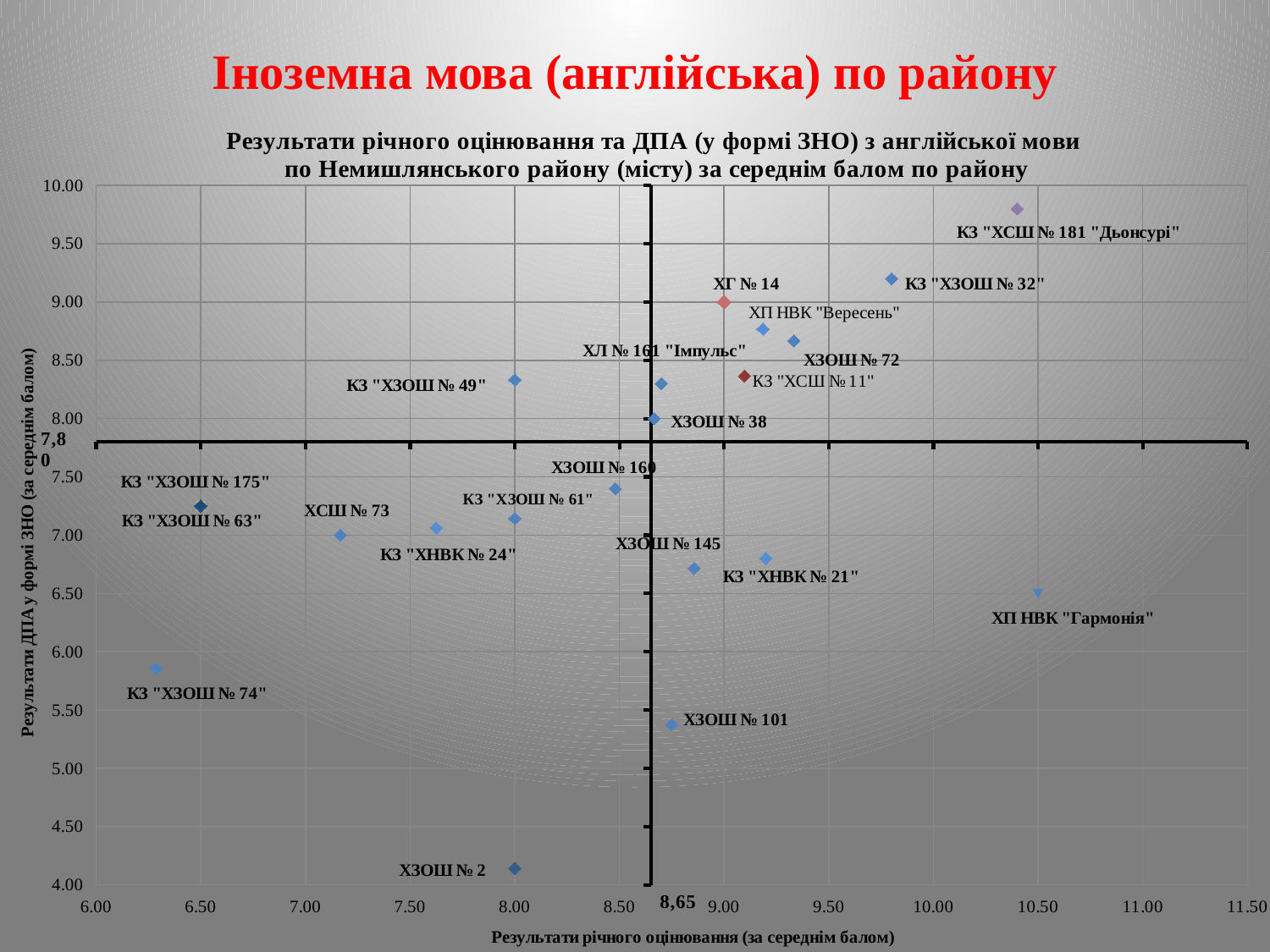
Is the ДПА result for ХЗОШ № 101 greater or less than 5.50? less Which has the higher ДПА result: ХЗОШ № 101 or ХЗОШ № 2? ХЗОШ № 101 What is the label of the x axis of the chart? Результати річного оцінювання (за середнім балом) Which has the higher annual assessment score: КЗ "ХЗОШ № 32" or ХГ № 14? КЗ "ХЗОШ № 32" Is the ДПА result for ХЗОШ № 2 greater or less than 4.50? less Which school has the lowest ДПА (ЗНО) result on the chart? ХЗОШ № 2 Is the ДПА result for КЗ "ХСШ № 181 "Дьонсурі" greater or less than 9.50? greater What kind of chart is shown on the slide? scatter chart Which school has the lowest annual assessment score (x axis) on the chart? КЗ "ХЗОШ № 74" What district average annual assessment score is marked on the x axis by the vertical line? 8,65 Which school has the highest ДПА (ЗНО) result on the chart? КЗ "ХСШ № 181 "Дьонсурі"